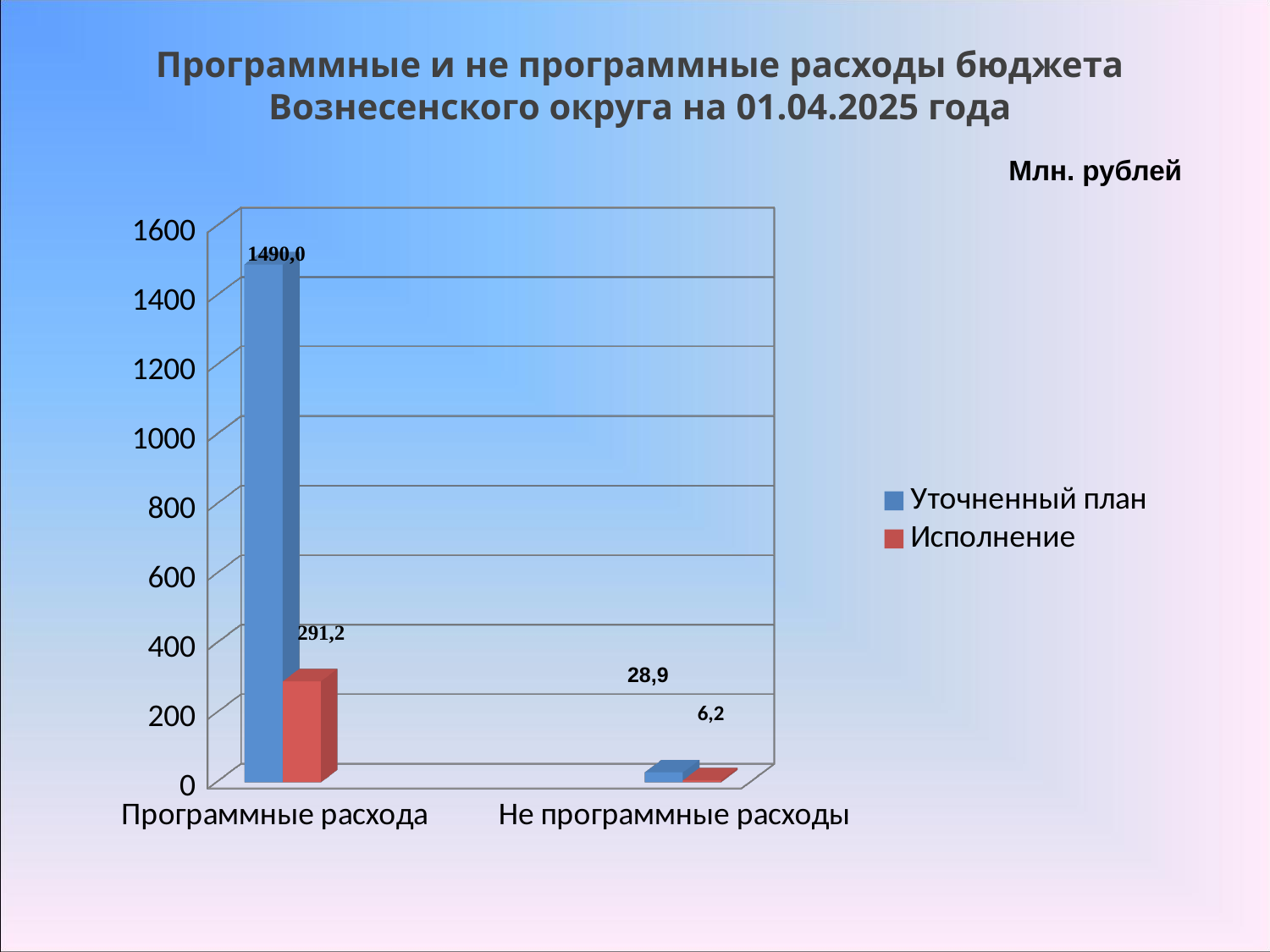
How many categories are shown on the x axis? 2 Which is larger: Исполнение for Программные расхода or Уточненный план for Не программные расходы? Исполнение for Программные расхода Which category has the lowest Исполнение value? Не программные расходы How many series does the legend list? 2 What is the difference between Уточненный план and Исполнение for Не программные расходы? 22,7 What kind of chart is shown on the slide? Bar chart What is the value of Исполнение for Не программные расходы? 6,2 What is the value of Уточненный план for Программные расхода? 1490,0 What is the value of Исполнение for Программные расхода? 291,2 What is the value of Уточненный план for Не программные расходы? 28,9 Which category has the highest Уточненный план value? Программные расхода What is the difference between Уточненный план and Исполнение for Программные расхода? 1198,8